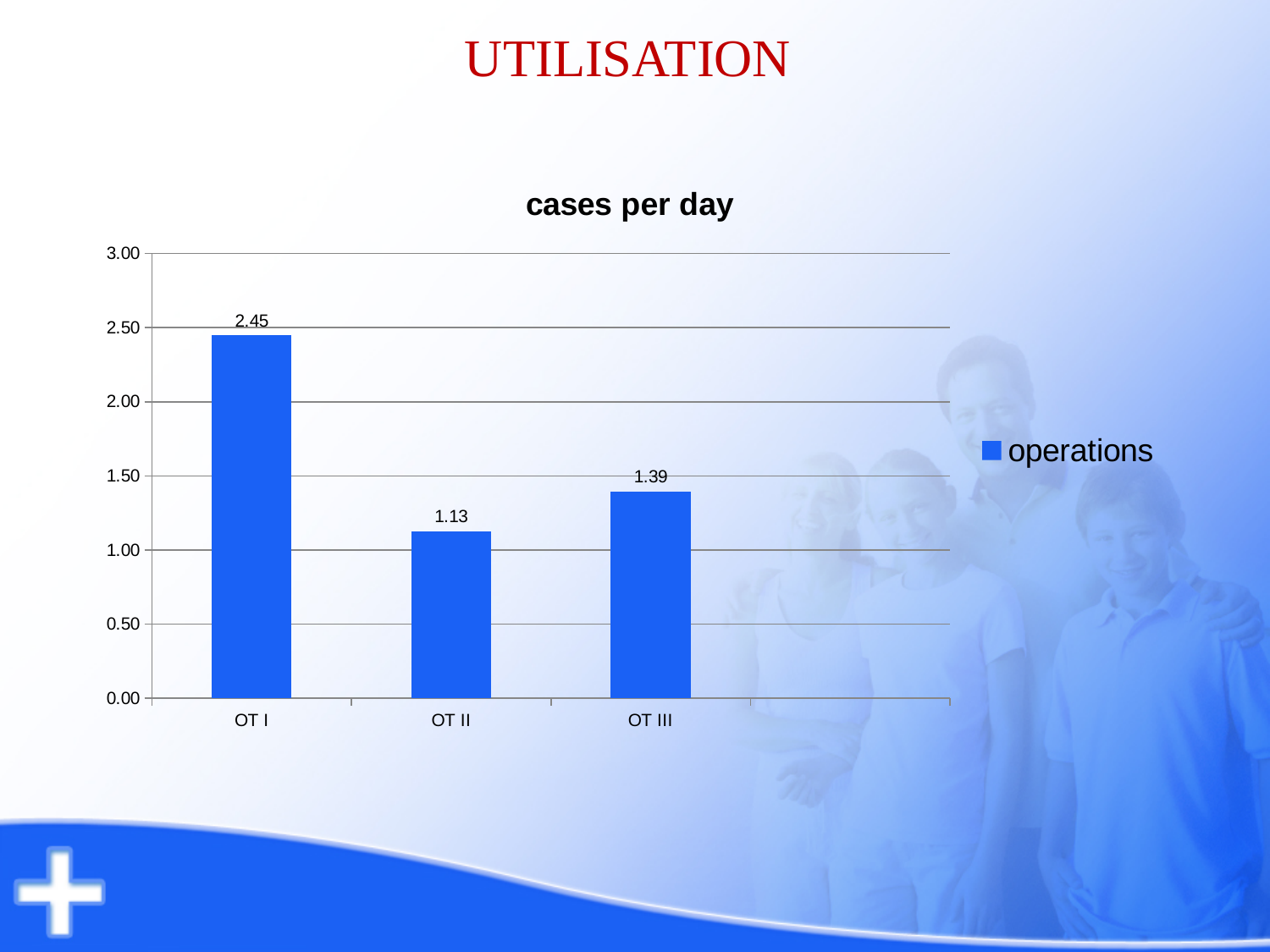
What is the value for OT III in the cases per day chart? 1.39 What kind of chart is shown on the slide? bar chart What is the value for OT II in the cases per day chart? 1.13 What is the difference between the values for OT III and OT II? 0.26 Which is larger, the value for OT II or OT III? OT III Is the value for OT I greater or less than 2.00? greater Which category has the lowest cases per day? OT II What is the difference between the values for OT I and OT II? 1.32 How many series does the legend list? 1 How many categories are shown on the x axis of the chart? 3 What is the value for OT I in the cases per day chart? 2.45 Which category has the highest cases per day? OT I